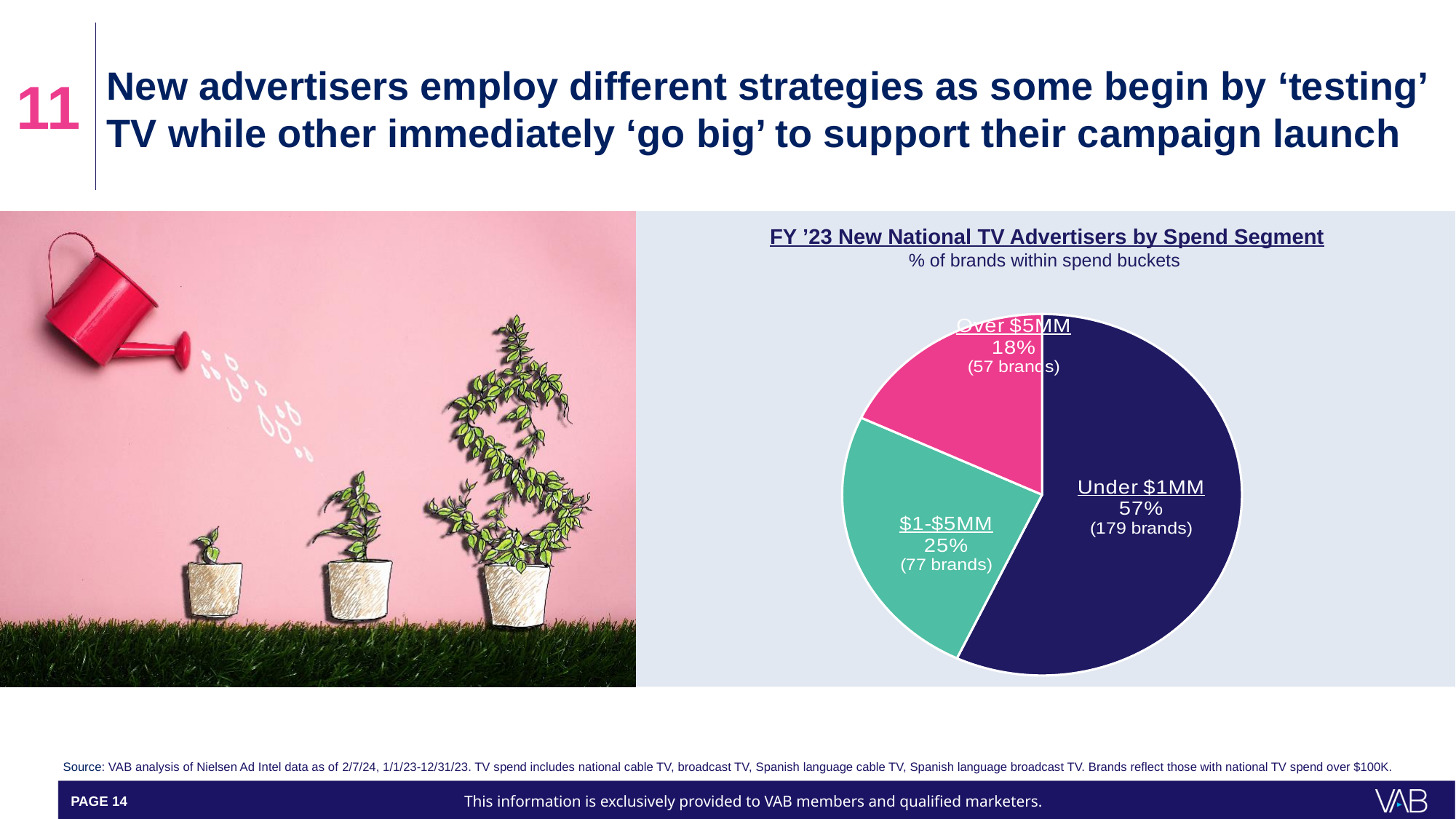
How many brands are in the Under $1MM segment? 179 brands What percentage of brands fall in the Under $1MM spend segment? 57% Which spend segment has the smallest share of brands? Over $5MM Which spend segment has the largest share of brands? Under $1MM What is the title of the chart? FY '23 New National TV Advertisers by Spend Segment What percentage of brands fall in the $1-$5MM spend segment? 25% What percentage of brands fall in the Over $5MM spend segment? 18% What type of chart is shown on the slide? Pie chart What is the difference in percentage points between the Under $1MM and $1-$5MM segments? 32 percentage points How many brands are in the Over $5MM segment? 57 brands How many spend segments are shown in the pie chart? 3 Which segment has more brands, $1-$5MM or Over $5MM? $1-$5MM